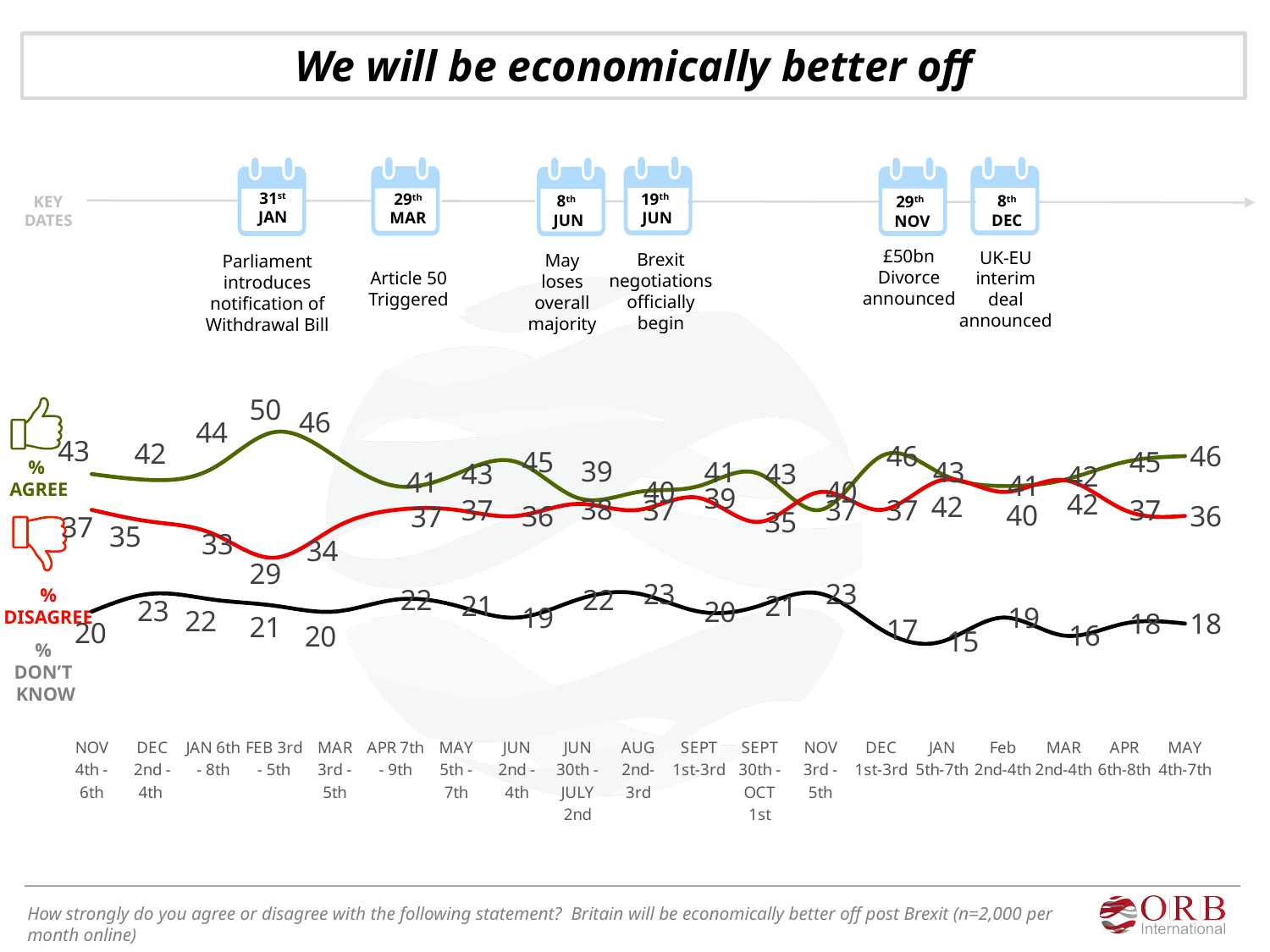
What is the % AGREE value for FEB 3rd - 5th? 50 For NOV 3rd - 5th, which is larger: % AGREE or % DISAGREE? % DISAGREE What is the % DON'T KNOW value for JAN 5th-7th? 15 According to the key dates timeline, on what date was Article 50 triggered? 29th MAR How many survey dates are plotted along the x axis? 19 How many series are plotted on the chart? 3 At which survey date does the % AGREE line reach its highest value? FEB 3rd - 5th What kind of chart is shown on the slide? line chart What is the % DISAGREE value for MAR 3rd - 5th? 34 What is the difference between % AGREE and % DISAGREE for MAY 4th-7th? 10 What is the % AGREE value for NOV 4th - 6th? 43 At which survey date is the % DISAGREE value lowest? FEB 3rd - 5th